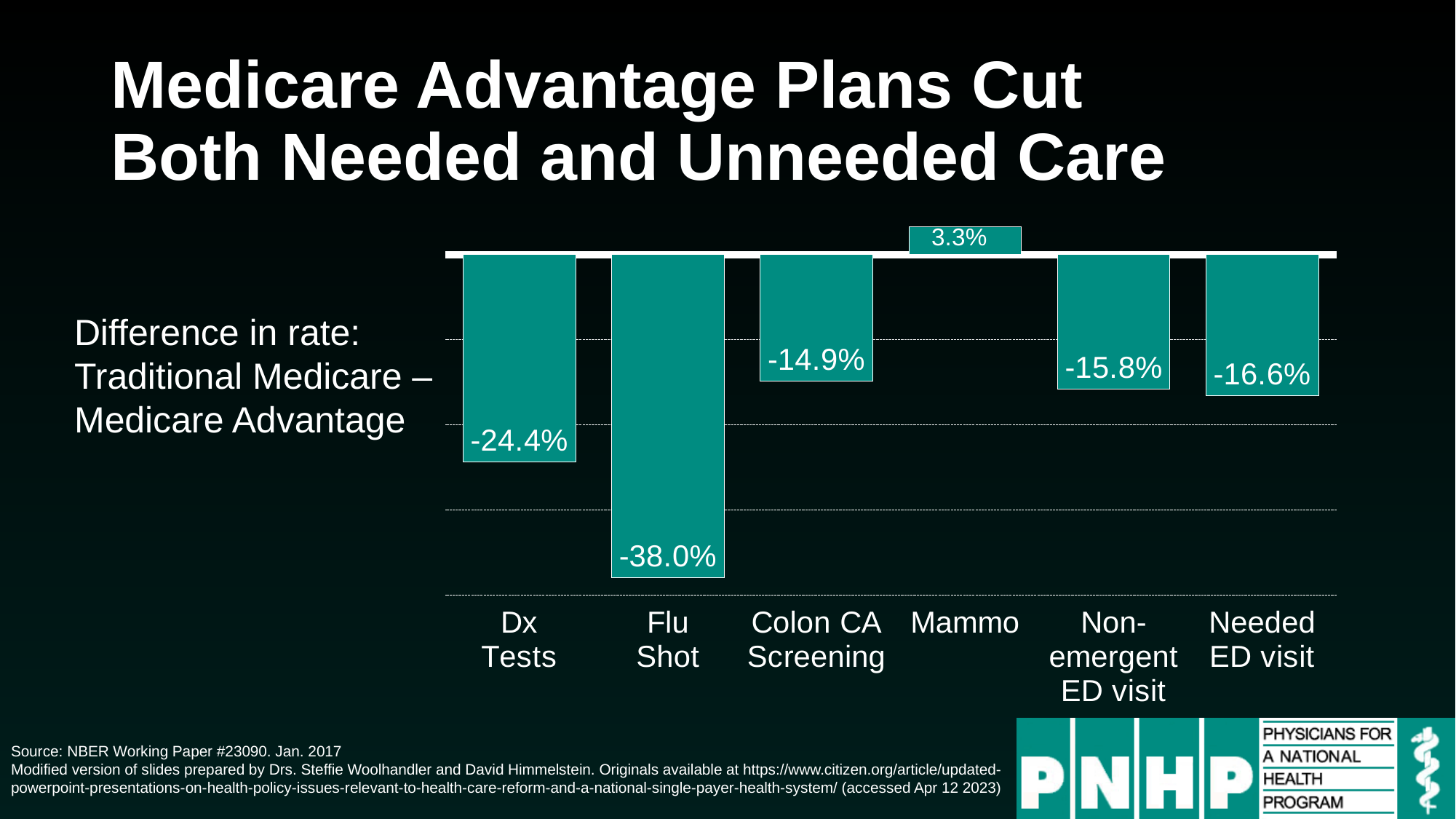
What is the value for Needed ED visit? -16.6% What is the value for Dx Tests? -24.4% What kind of chart is shown on the slide? Bar chart Which category has the highest value? Mammo Which category has the lowest value? Flu Shot How many categories have a positive value? 1 What is the difference between the values for Dx Tests and Flu Shot? 13.6 percentage points What is the value for Mammo? 3.3% Which is larger, the value for Colon CA Screening or the value for Non-emergent ED visit? Colon CA Screening How many categories are shown on the chart? 6 What is the value for Flu Shot? -38.0% What does the text to the left of the chart say the bars represent? Difference in rate: Traditional Medicare – Medicare Advantage